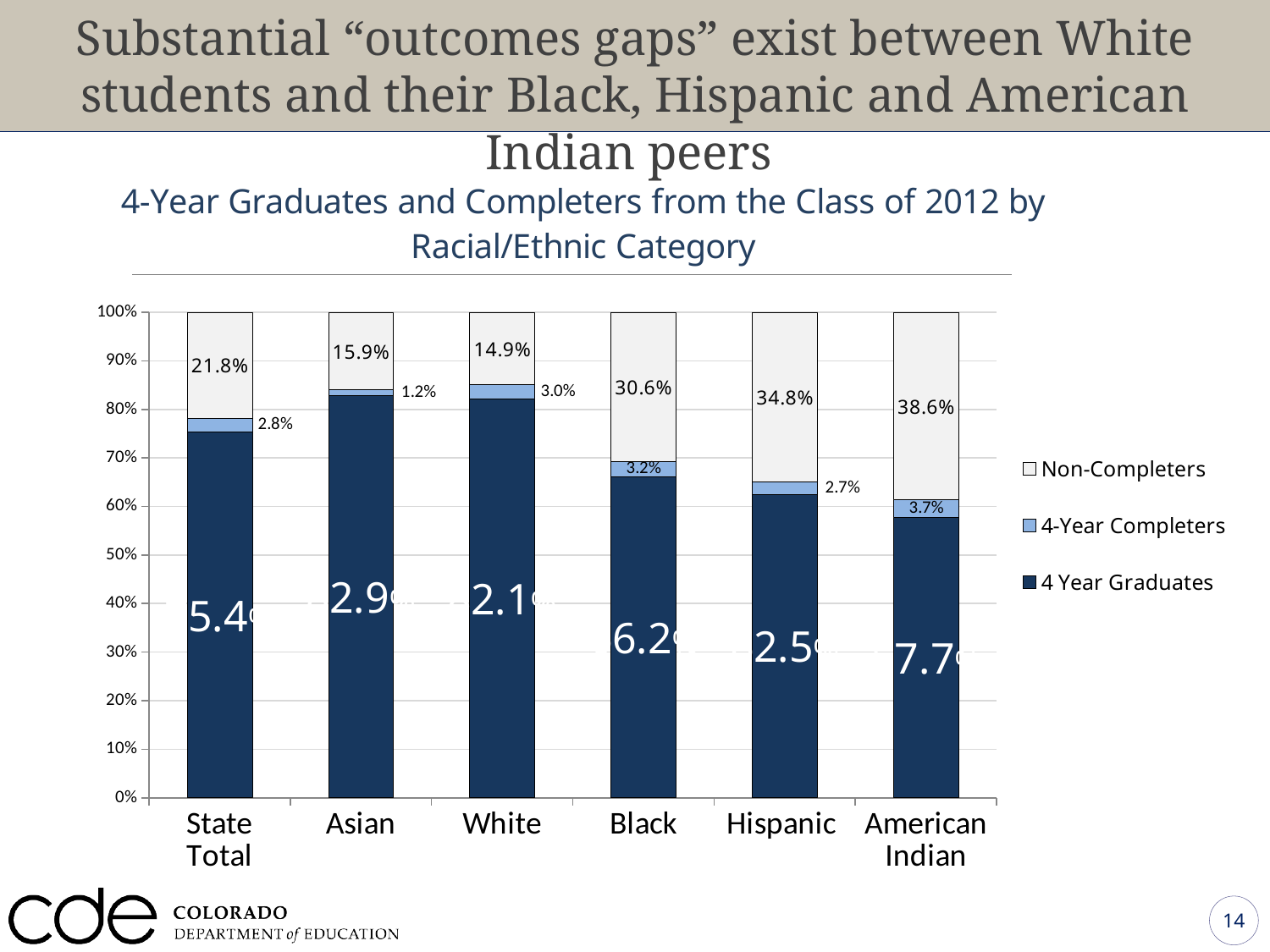
What is the 4-Year Completers value for Asian students? 1.2% What is the Non-Completers value for Hispanic students? 34.8% Which category has the highest 4-Year Completers percentage? American Indian Which has a larger Non-Completers percentage, Hispanic or Black? Hispanic Which category has the lowest Non-Completers percentage? White Which category has the highest Non-Completers percentage? American Indian What is the difference in Non-Completers percentage between American Indian and White students? 23.7 percentage points What is the Non-Completers value for Black students? 30.6% How many racial/ethnic categories are shown on the x axis? 6 How many series does the legend list? 3 Is the 4 Year Graduates value for State Total greater or less than 70%? greater Is the 4 Year Graduates value for Black students greater or less than 70%? less